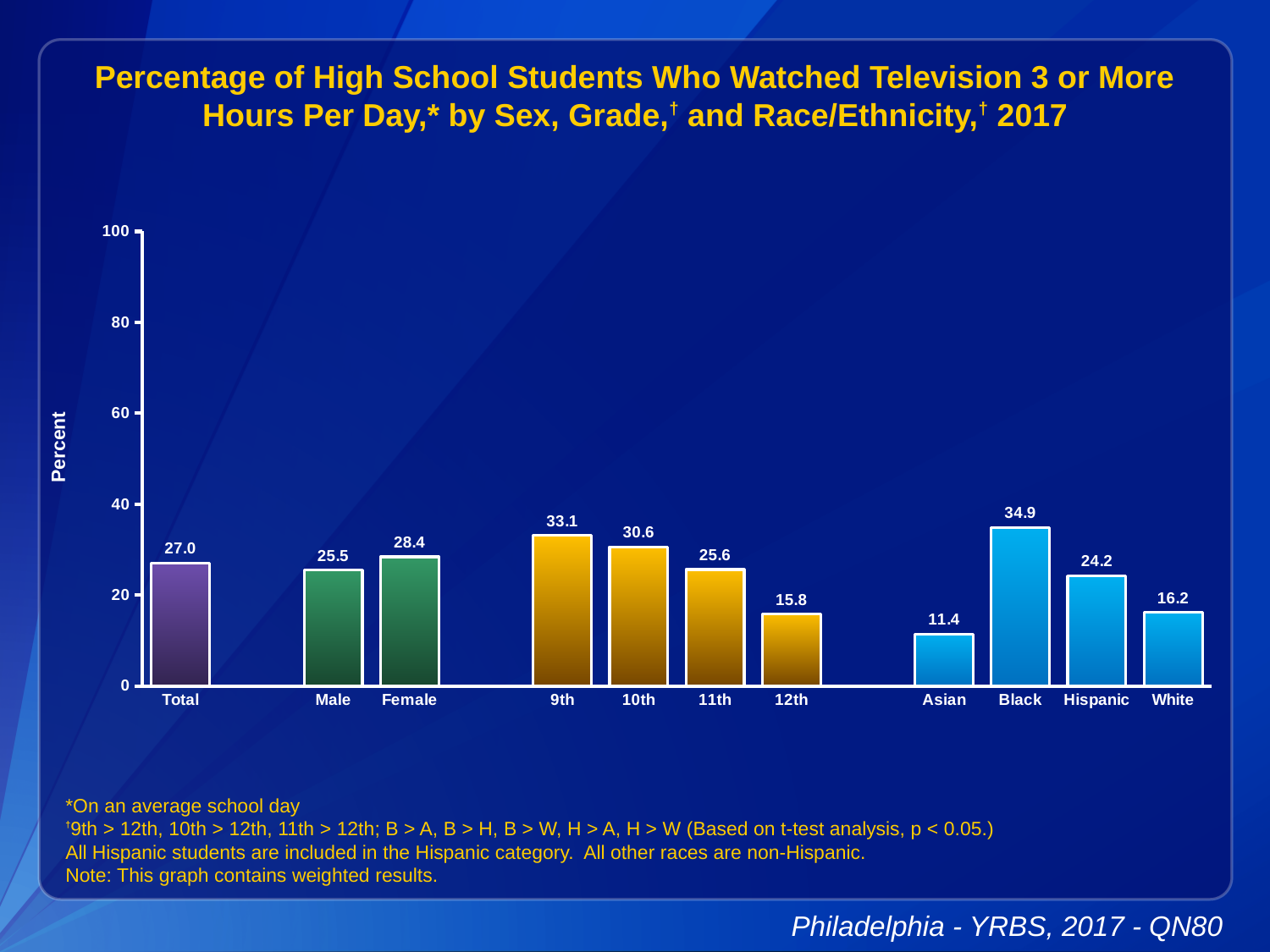
Which category has the highest value? Black What kind of chart is this? Bar chart What is the value for Female? 28.4 How many categories are shown on the x axis? 11 What is the value for Total? 27.0 What is the difference between the values for Female and Male? 2.9 Which category has the lowest value? Asian What is the difference between the values for 9th and 12th grade? 17.3 Do the values rise or fall from 9th grade to 12th grade? Fall Which is larger, the value for 10th grade or the value for 11th grade? 10th What is the value for Hispanic? 24.2 What is the value for 12th grade? 15.8